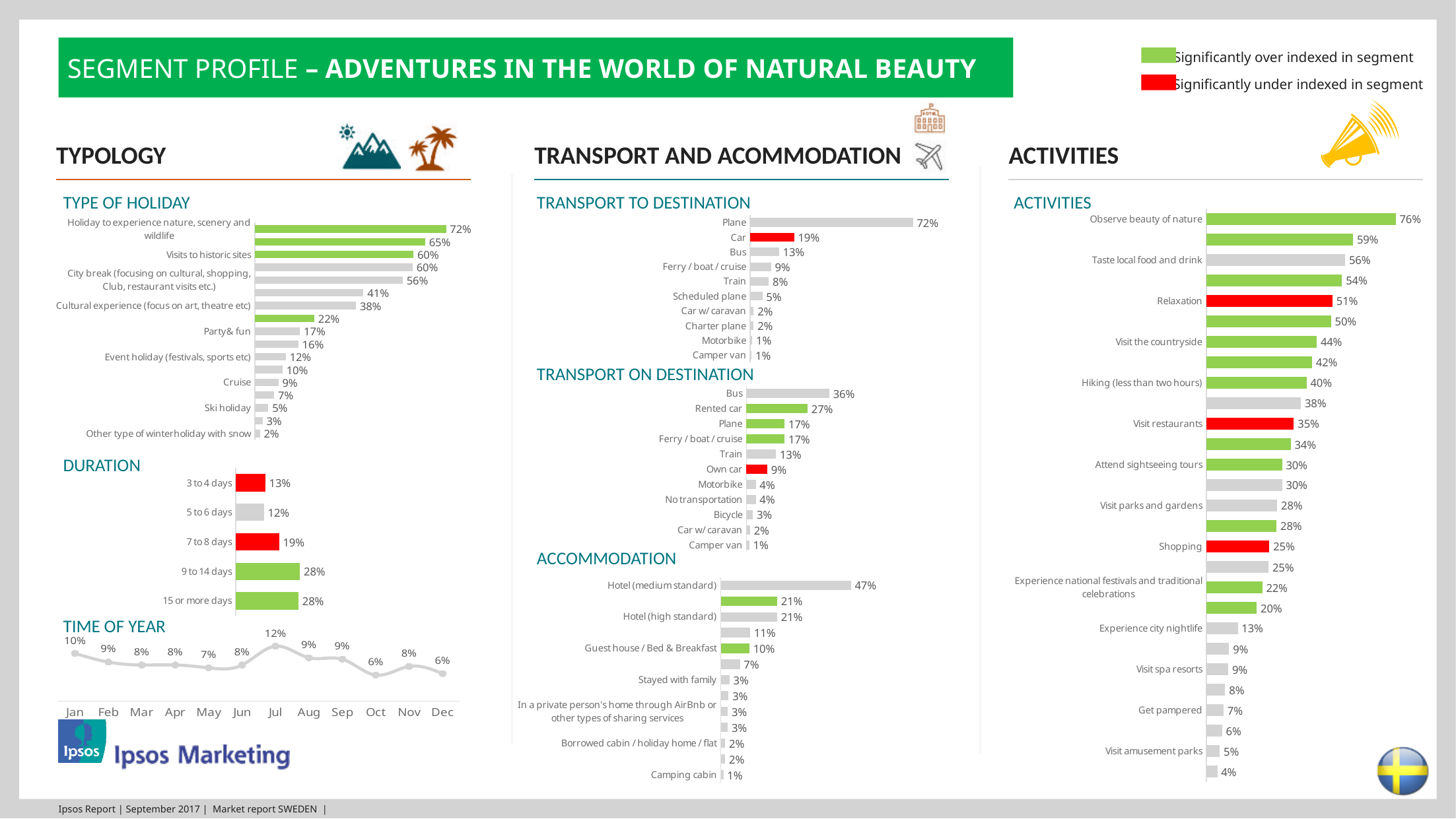
In the Transport on Destination chart, what is the difference between Bus and Rented car? 9% In the Duration chart, which is larger, 3 to 4 days or 5 to 6 days? 3 to 4 days In the Transport on Destination chart, which category has the highest value? Bus In the Duration chart, what is the value for 7 to 8 days? 19% In the Accommodation chart, what is the value for Hotel (medium standard)? 47% In the Activities chart, what is the value for Observe beauty of nature? 76% In the Time of Year chart, what is the value for Oct? 6% In the Time of Year chart, which month has the highest value? Jul In the Transport to Destination chart, what is the value for Car? 19% What kind of chart is the Time of Year chart? Line chart In the Transport to Destination chart, what is the value for Plane? 72% In the Type of Holiday chart, what is the value for Cruise? 9%